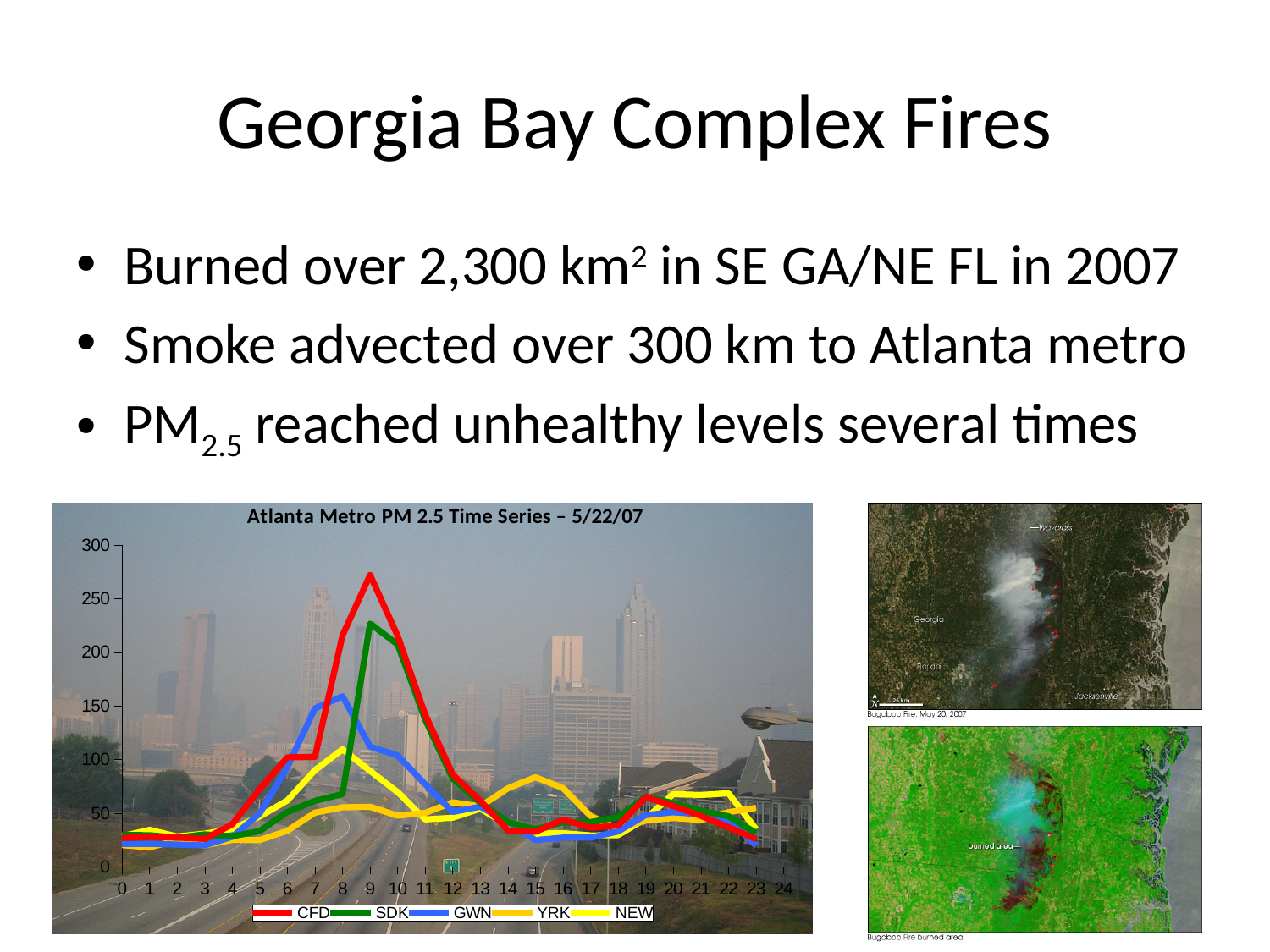
How many series does the legend of the Atlanta Metro PM 2.5 chart list? 5 Is the peak value of the SDK series greater or less than 250? less Which series is drawn in red in the Atlanta Metro PM 2.5 chart? CFD Which series reaches the highest value on the Atlanta Metro PM 2.5 chart? CFD What kind of chart is shown on the slide? line chart At hour 9, which series has the larger value, CFD or GWN? CFD Is the peak value of the SDK series greater or less than 200? greater Is the peak value of the CFD series greater or less than 250? greater What is the title of the chart on the slide? Atlanta Metro PM 2.5 Time Series – 5/22/07 Does the CFD series rise or fall between hour 9 and hour 14? fall